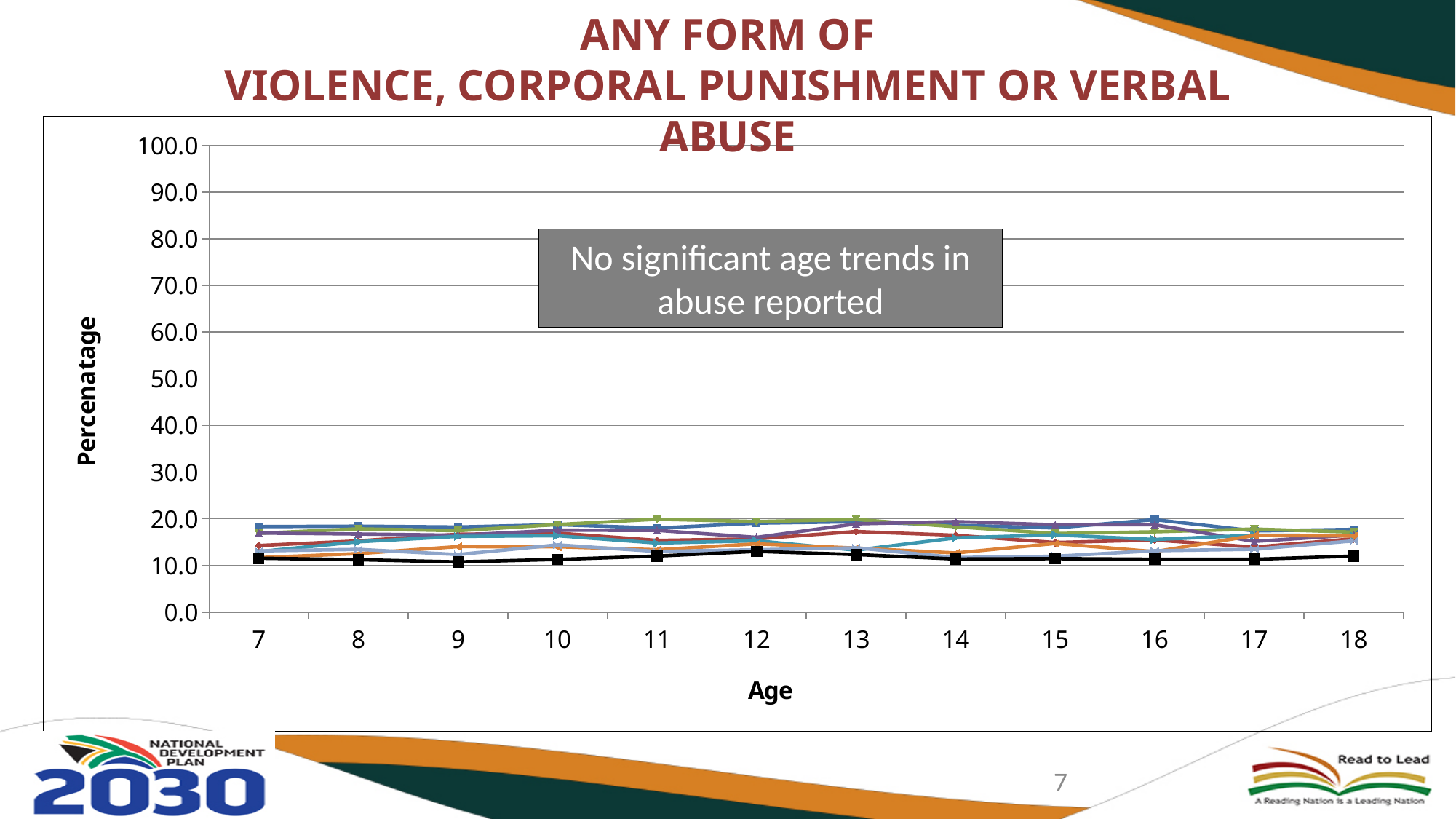
What is the highest tick value shown on the y axis? 100.0 What does the text box on the chart say about age trends? No significant age trends in abuse reported Is the highest plotted value on the chart greater or less than 30? less At age 9, is the black line above or below the green line? below What is the last age shown on the x axis? 18 What is the first age shown on the x axis? 7 Is the value of the black line at age 12 greater or less than 10? greater How many age categories are plotted along the x axis? 12 What kind of chart is shown on the slide? line chart Do the plotted lines show a strong rising or falling trend from age 7 to age 18? no Is the value of the black line at age 9 greater or less than 20? less What is the title of the slide? ANY FORM OF VIOLENCE, CORPORAL PUNISHMENT OR VERBAL ABUSE